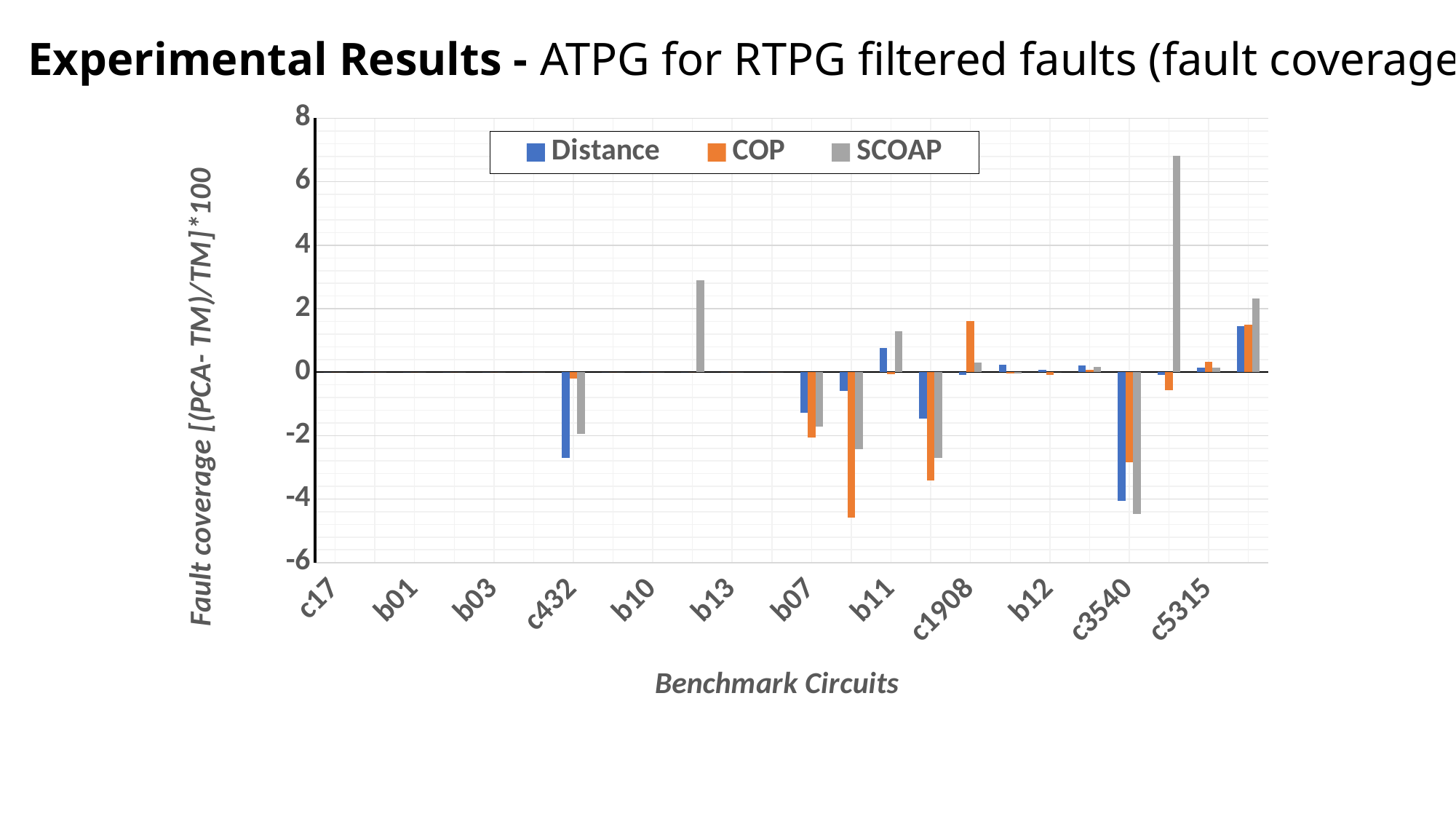
What is the highest value shown on the y axis? 8 How many series does the legend list? 3 Is the lowest COP bar greater or less than -4? less How many benchmark circuit labels are readable on the x axis? 12 Is the tallest SCOAP bar greater or less than 6? greater Is the Distance bar at c432 greater or less than -2? less What kind of chart is shown on the slide? bar chart Which series has the tallest positive bar in the chart? SCOAP What are the three series named in the legend? Distance, COP, SCOAP What is the title of the y axis? Fault coverage [(PCA- TM)/TM] *100